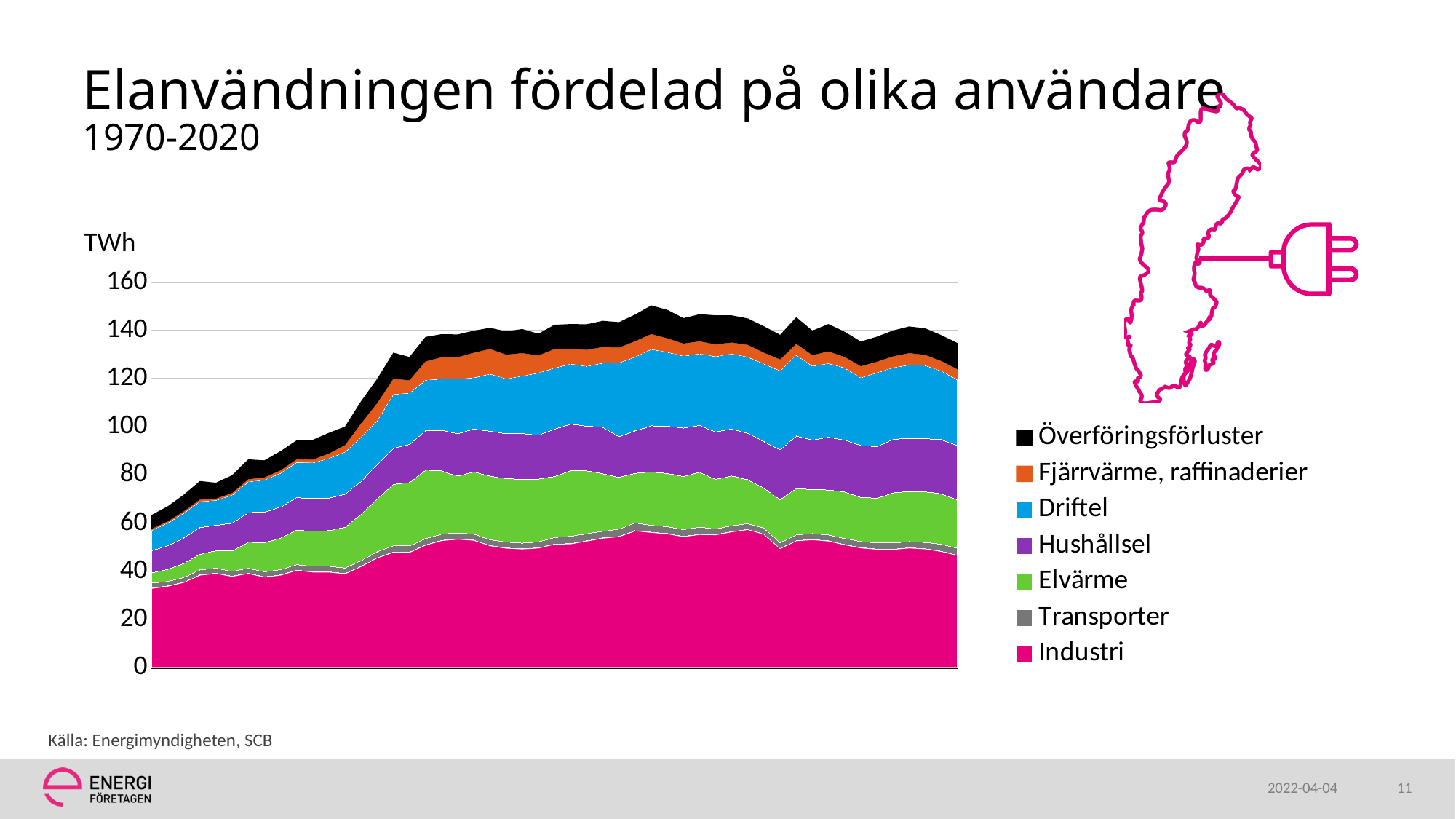
Which series occupies the smallest area in the chart? Transporter What is the title of the chart on the slide? Elanvändningen fördelad på olika användare 1970-2020 What kind of chart is shown on the slide? Stacked area chart Is the Industri value at the end of the period (2020) greater or less than 60? less Is the total electricity use at the start of the period (1970) greater or less than 80? less What unit is shown on the y axis of the chart? TWh Which series occupies the largest area in the chart? Industri How many series does the legend list? 7 Which series is larger throughout the chart, Driftel or Transporter? Driftel Does the total electricity use rise or fall over the first part of the period, from 1970 to around 1990? rise Is the total electricity use at the end of the period (2020) greater or less than 120? greater